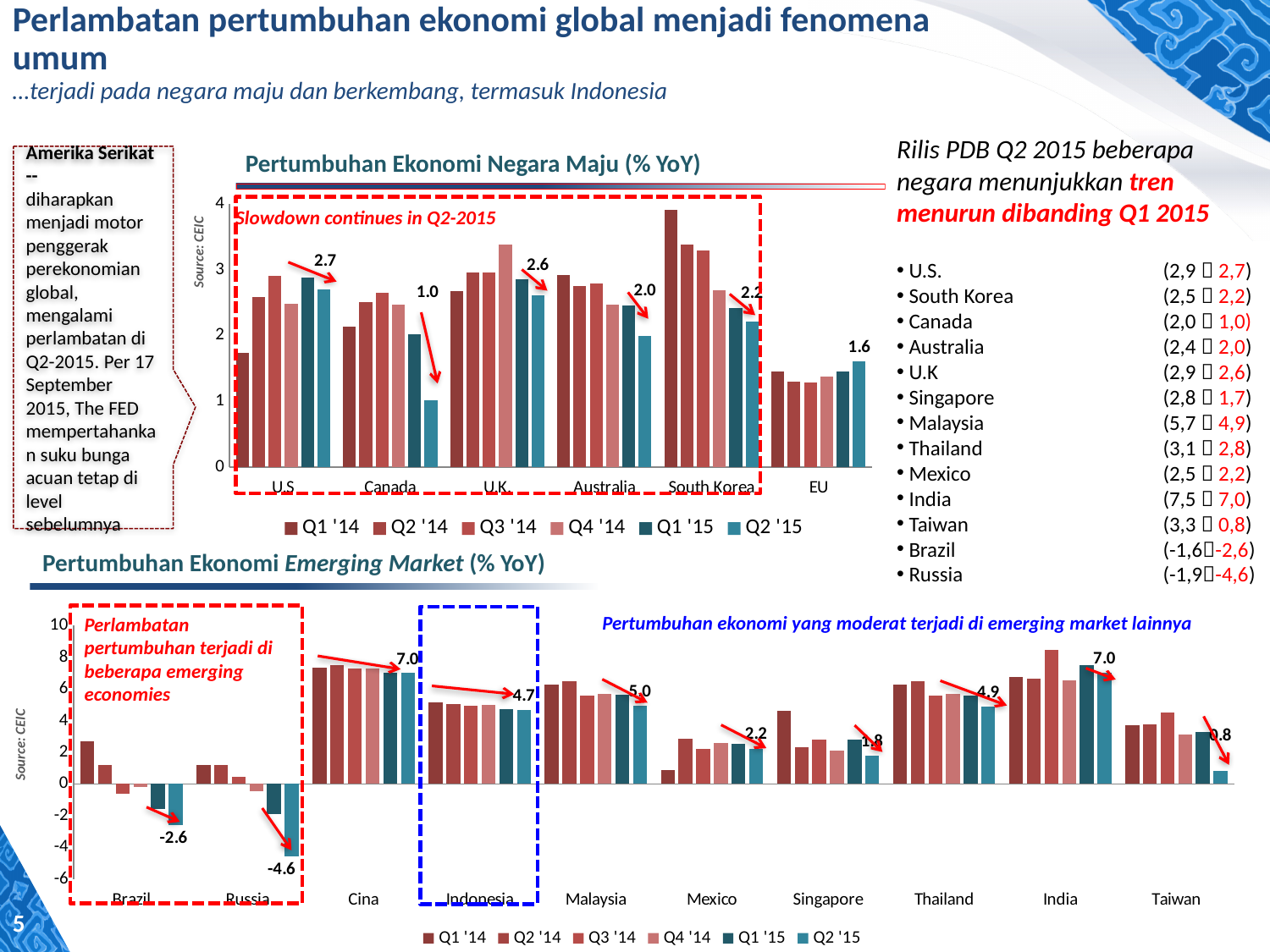
In the chart 'Pertumbuhan Ekonomi Emerging Market (% YoY)', what is the labelled Q2 '15 value for Indonesia? 4.7 In the chart 'Pertumbuhan Ekonomi Negara Maju (% YoY)', what is the difference between the labelled Q2 '15 values for the U.S and Canada? 1.7 In the chart 'Pertumbuhan Ekonomi Negara Maju (% YoY)', what is the labelled Q2 '15 value for the U.K? 2.6 In the chart 'Pertumbuhan Ekonomi Negara Maju (% YoY)', how many series does the legend list? 6 In the chart 'Pertumbuhan Ekonomi Negara Maju (% YoY)', what is the labelled Q2 '15 value for Canada? 1.0 In the chart 'Pertumbuhan Ekonomi Emerging Market (% YoY)', which is larger, the labelled Q2 '15 value for Malaysia or for Mexico? Malaysia In the chart 'Pertumbuhan Ekonomi Emerging Market (% YoY)', how many countries are shown on the x axis? 10 In the chart 'Pertumbuhan Ekonomi Emerging Market (% YoY)', is the Q1 '14 value for Singapore greater or less than 4? greater In the chart 'Pertumbuhan Ekonomi Emerging Market (% YoY)', which country has the lowest labelled Q2 '15 value? Russia In the chart 'Pertumbuhan Ekonomi Negara Maju (% YoY)', how many countries are shown on the x axis? 6 What type of chart is 'Pertumbuhan Ekonomi Emerging Market (% YoY)'? Bar chart In the chart 'Pertumbuhan Ekonomi Negara Maju (% YoY)', which country has the highest labelled Q2 '15 value? U.S